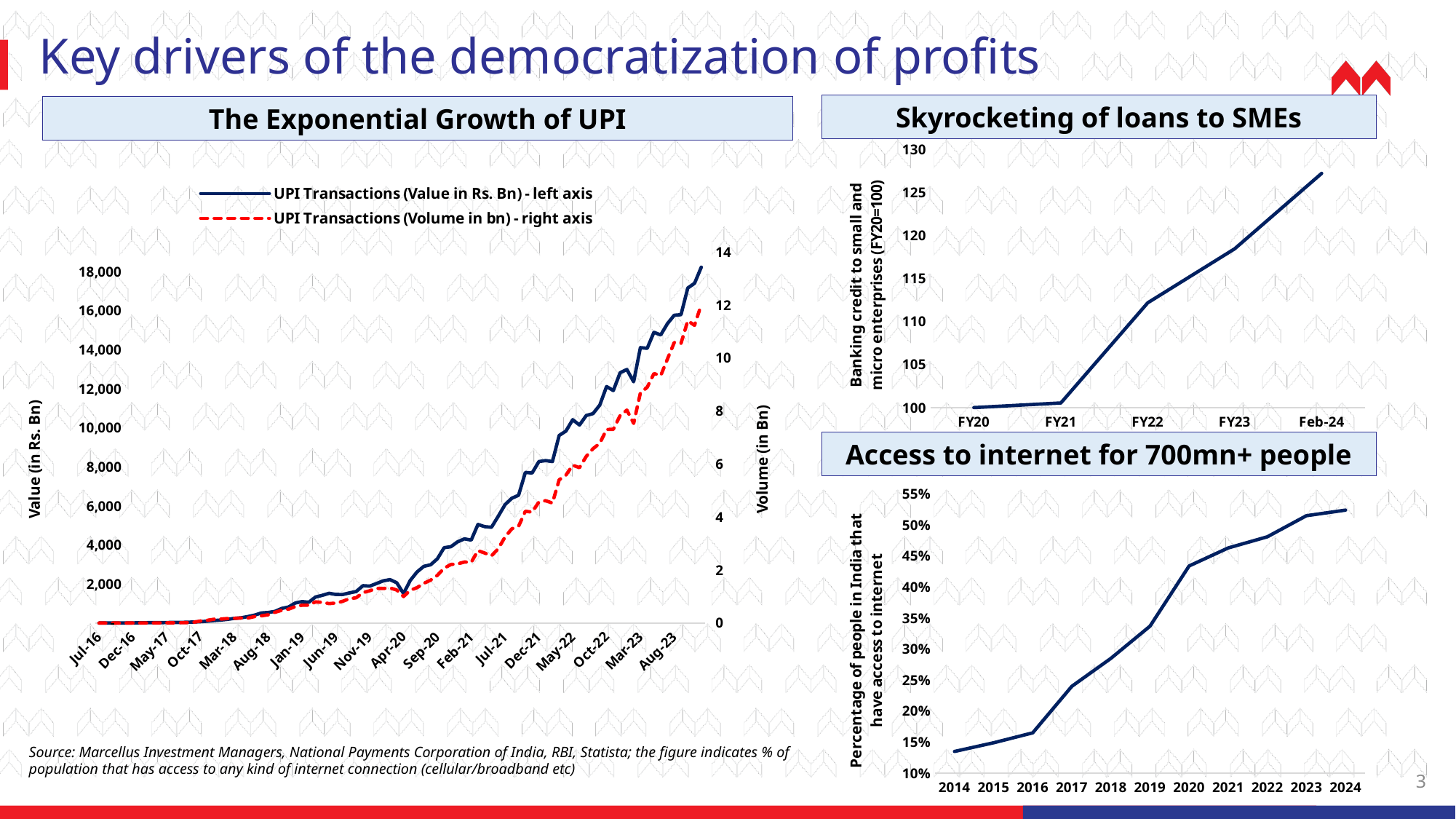
In 'The Exponential Growth of UPI', do UPI transaction values rise or fall from Jul-16 to the end of the series? rise What kind of chart is 'The Exponential Growth of UPI'? line chart In 'Access to internet for 700mn+ people', is the value for 2024 greater or less than 50%? greater In 'Skyrocketing of loans to SMEs', what is the index value for FY20? 100 In 'Access to internet for 700mn+ people', how many years are plotted on the x axis? 11 In 'Skyrocketing of loans to SMEs', is the value for Feb-24 greater or less than 125? greater In 'The Exponential Growth of UPI', which series is plotted on the right axis? UPI Transactions (Volume in bn) In 'Skyrocketing of loans to SMEs', which period has the highest value? Feb-24 In 'Access to internet for 700mn+ people', which year has the lowest value? 2014 In 'Skyrocketing of loans to SMEs', how many time points are plotted on the x axis? 5 How many series does the legend of 'The Exponential Growth of UPI' list? 2 In 'The Exponential Growth of UPI', is the UPI transaction value at Aug-23 greater or less than 14,000? greater